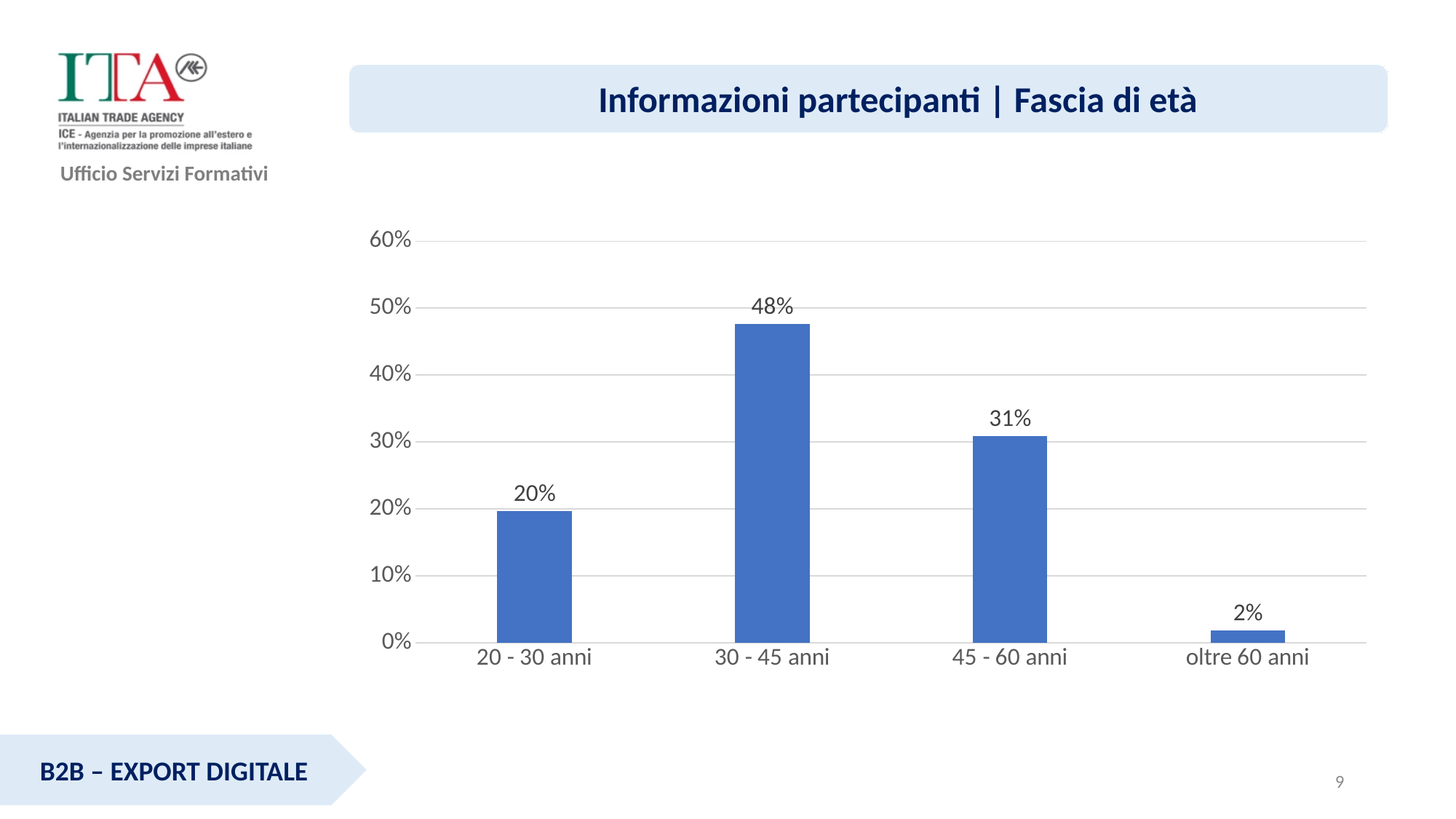
How many age groups are shown on the chart? 4 What is the difference between the values for 20 - 30 anni and oltre 60 anni? 18% Which is larger, the value for 45 - 60 anni or the value for 20 - 30 anni? 45 - 60 anni What is the title of the slide containing the chart? Informazioni partecipanti | Fascia di età Which age group has the lowest value? oltre 60 anni What is the value for the oltre 60 anni age group? 2% What is the difference between the values for 30 - 45 anni and 45 - 60 anni? 17% Is the value for 45 - 60 anni greater or less than 40%? less What is the value for the 20 - 30 anni age group? 20% Which age group has the highest value? 30 - 45 anni What kind of chart is shown on the slide? bar chart What is the value for the 30 - 45 anni age group? 48%